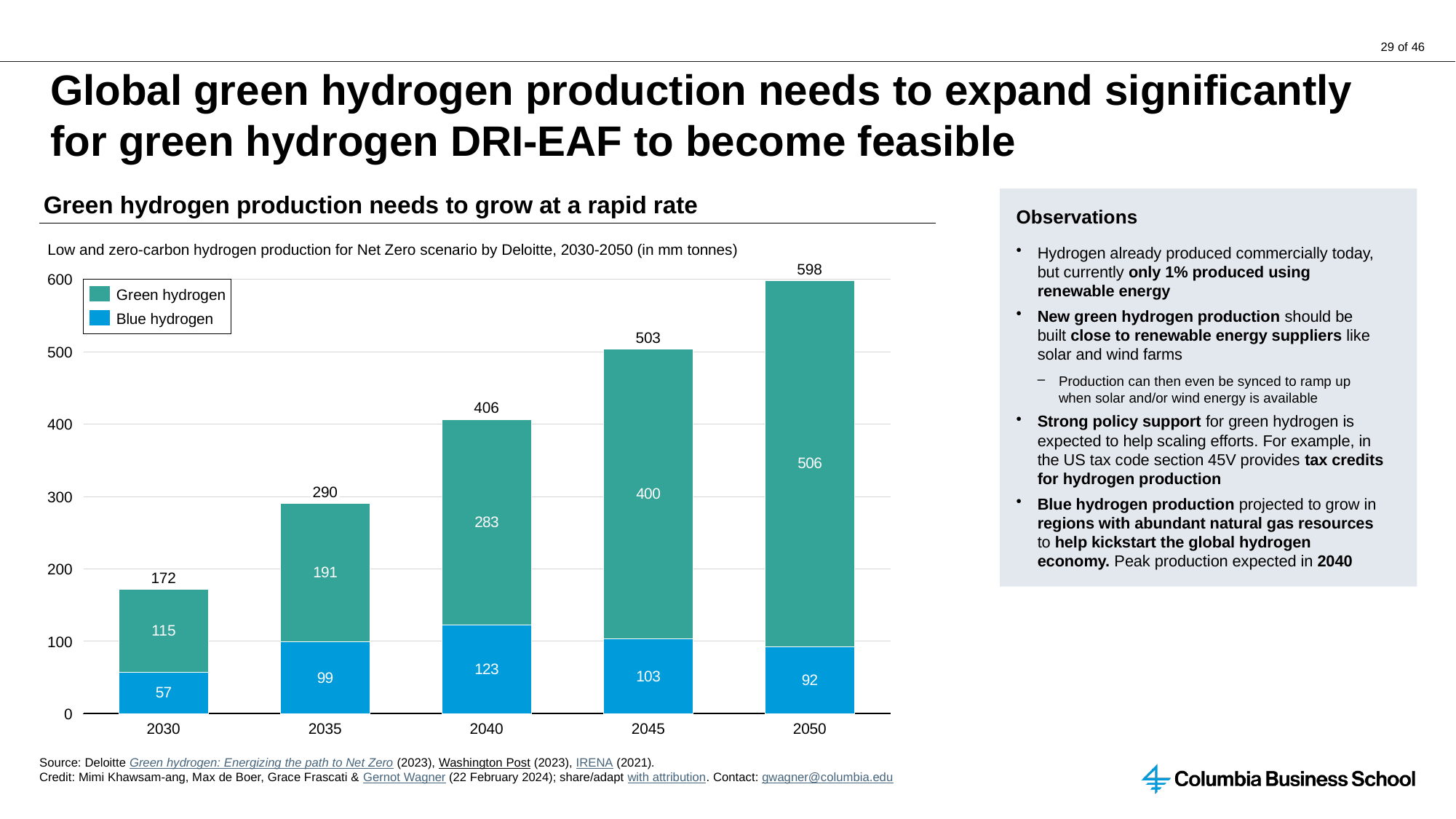
What is the green hydrogen value for 2040? 283 What is the difference between the green hydrogen values for 2050 and 2045? 106 How many years are shown on the x axis? 5 Is the total for 2035 greater or less than 300? less What is the total of the stacked bar for 2045? 503 How many series does the legend list? 2 Do the total values rise or fall from 2030 to 2050? Rise What is the blue hydrogen value for 2030? 57 What kind of chart is shown? Stacked bar chart Which year has the lowest blue hydrogen value? 2030 Which is larger, the blue hydrogen value for 2040 or for 2035? 2040 Which year has the highest total hydrogen production? 2050